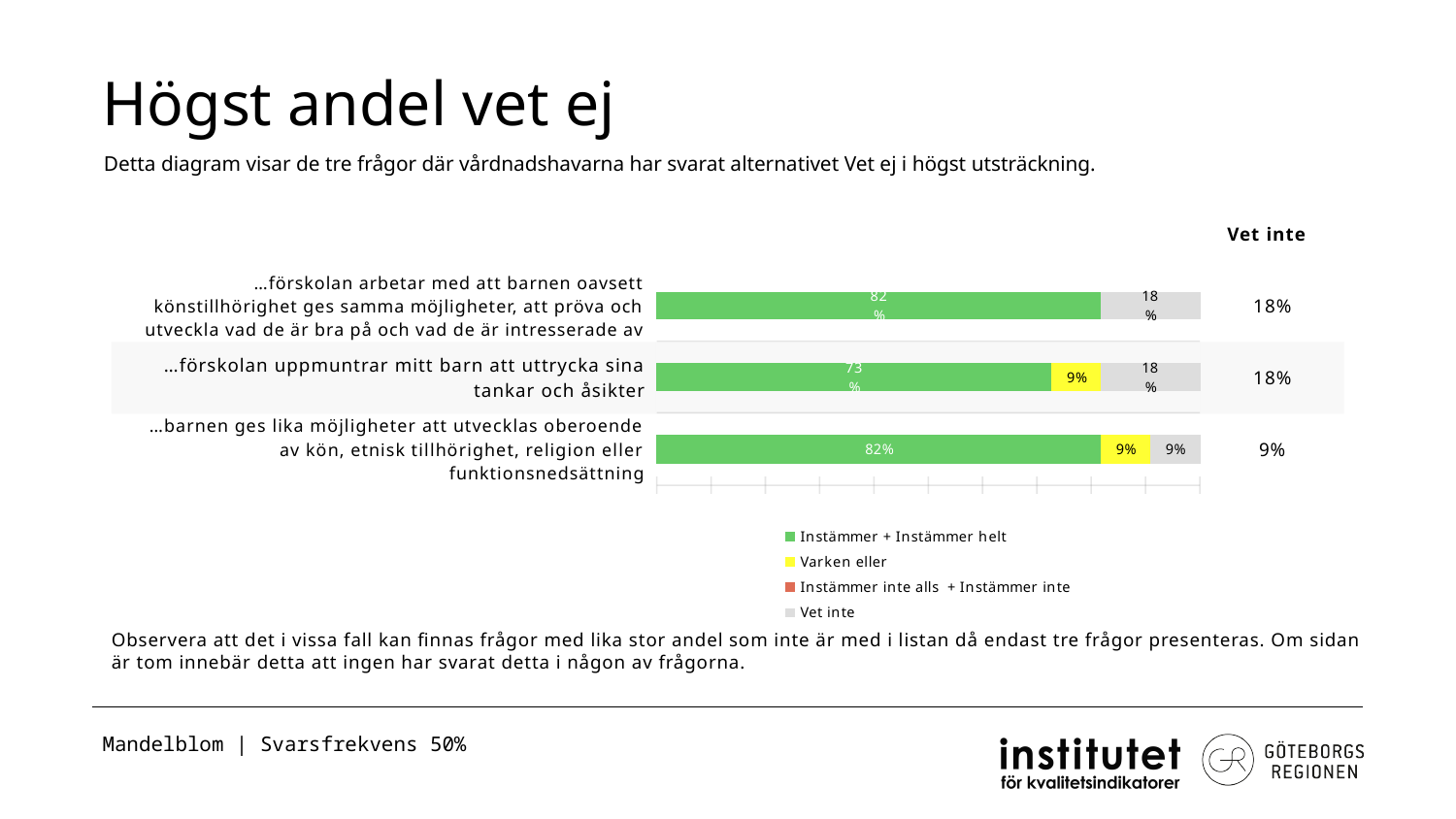
What is the 'Vet inte' value for '…förskolan uppmuntrar mitt barn att uttrycka sina tankar och åsikter'? 18% Is the 'Vet inte' value larger for '…förskolan uppmuntrar mitt barn att uttrycka sina tankar och åsikter' or for '…barnen ges lika möjligheter att utvecklas oberoende av kön…'? …förskolan uppmuntrar mitt barn att uttrycka sina tankar och åsikter What is the 'Instämmer + Instämmer helt' value for '…förskolan uppmuntrar mitt barn att uttrycka sina tankar och åsikter'? 73% What is the difference between the 'Instämmer + Instämmer helt' values for '…förskolan arbetar med att barnen oavsett könstillhörighet ges samma möjligheter…' and '…förskolan uppmuntrar mitt barn att uttrycka sina tankar och åsikter'? 9% What is the 'Vet inte' value for '…barnen ges lika möjligheter att utvecklas oberoende av kön, etnisk tillhörighet, religion eller funktionsnedsättning'? 9% How many questions (categories) are shown in the chart? 3 What is the 'Varken eller' value for '…barnen ges lika möjligheter att utvecklas oberoende av kön, etnisk tillhörighet, religion eller funktionsnedsättning'? 9% Which question has the lowest 'Vet inte' share? …barnen ges lika möjligheter att utvecklas oberoende av kön, etnisk tillhörighet, religion eller funktionsnedsättning How many series does the legend list? 4 What kind of chart is shown on the slide? stacked bar chart Which question has the lowest 'Instämmer + Instämmer helt' share? …förskolan uppmuntrar mitt barn att uttrycka sina tankar och åsikter What is the title of the slide containing the chart? Högst andel vet ej